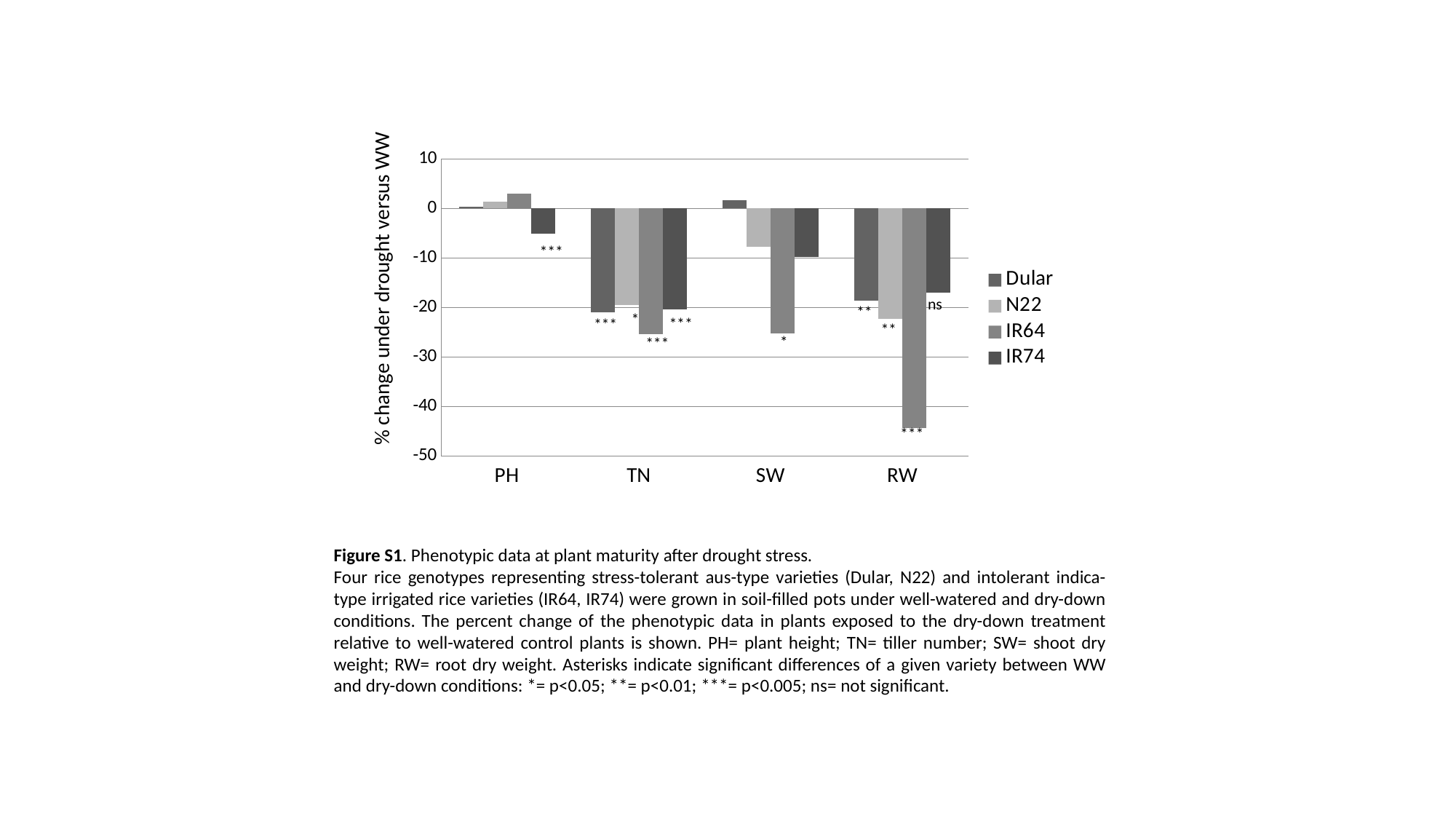
Is the value for N22 in the SW category greater or less than -10? greater What kind of chart is shown on the slide? bar chart Is the value for IR64 in the TN category greater or less than -20? less How many categories are shown on the x axis of the chart? 4 Which is larger, the value for IR74 in the SW category or the value for IR74 in the RW category? IR74 in SW Is the value for IR64 in the RW category greater or less than -40? less Which series has the lowest value in the RW category? IR64 Which series has the highest value in the PH category? IR64 Which is larger, the value for Dular in the PH category or the value for Dular in the TN category? Dular in PH Which series has the lowest value in the SW category? IR64 How many series does the chart legend list? 4 What is the label of the y axis of the chart? % change under drought versus WW